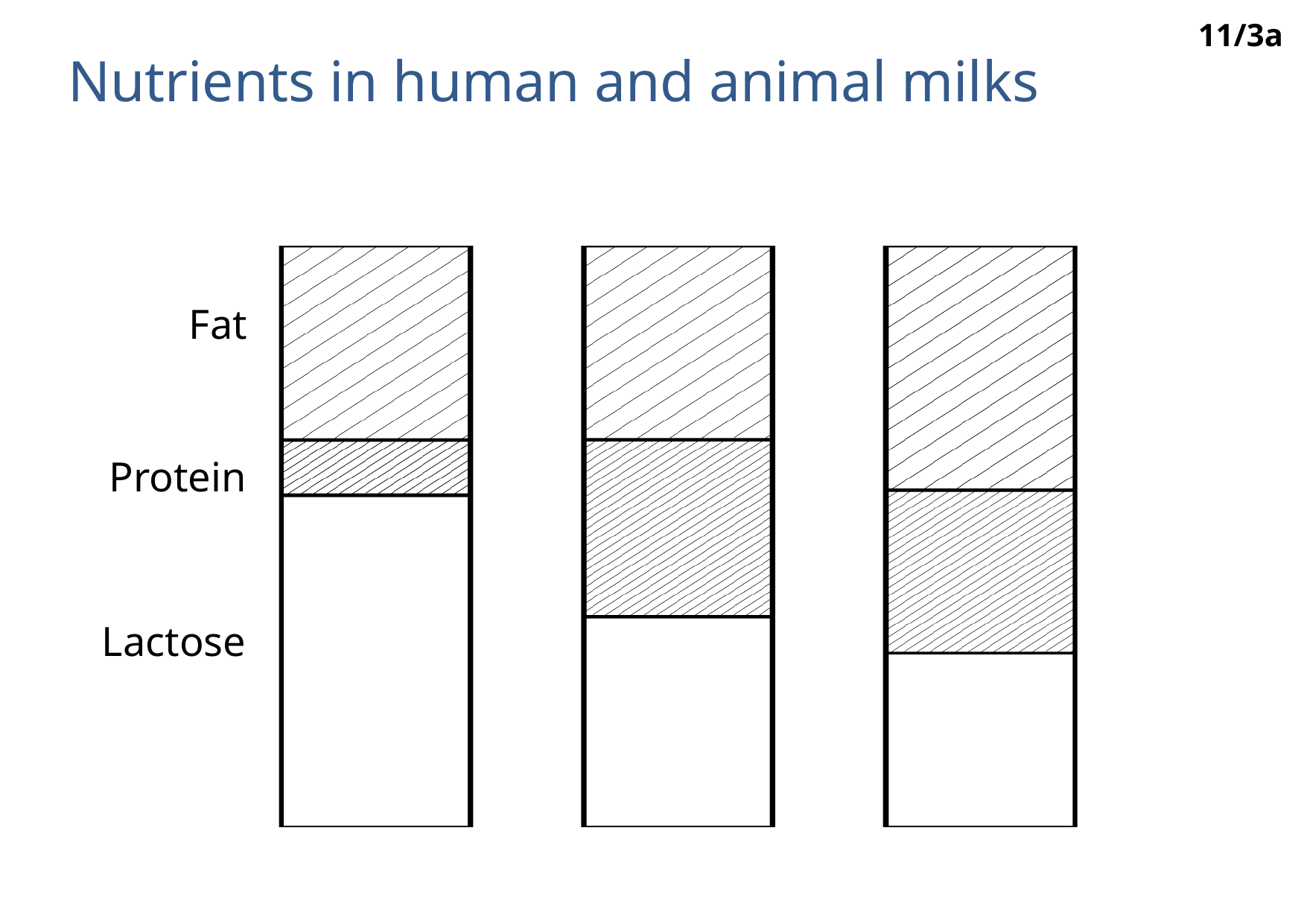
Is the Lactose segment larger in the middle bar or the right bar? Middle bar How many nutrient segments are labelled in the chart? 3 Which bar has the largest Protein segment: the left, middle or right bar? Middle bar What is the title of the chart? Nutrients in human and animal milks What kind of chart is shown on the slide? Stacked bar chart Which segment is at the top of each stacked bar? Fat Is the Protein segment larger in the left bar or the middle bar? Middle bar How many bars are shown in the chart? 3 Which nutrients are labelled on the chart? Fat, Protein, Lactose Which bar has the largest Lactose segment: the left, middle or right bar? Left bar Which bar has the smallest Lactose segment: the left, middle or right bar? Right bar Which bar has the smallest Protein segment: the left, middle or right bar? Left bar